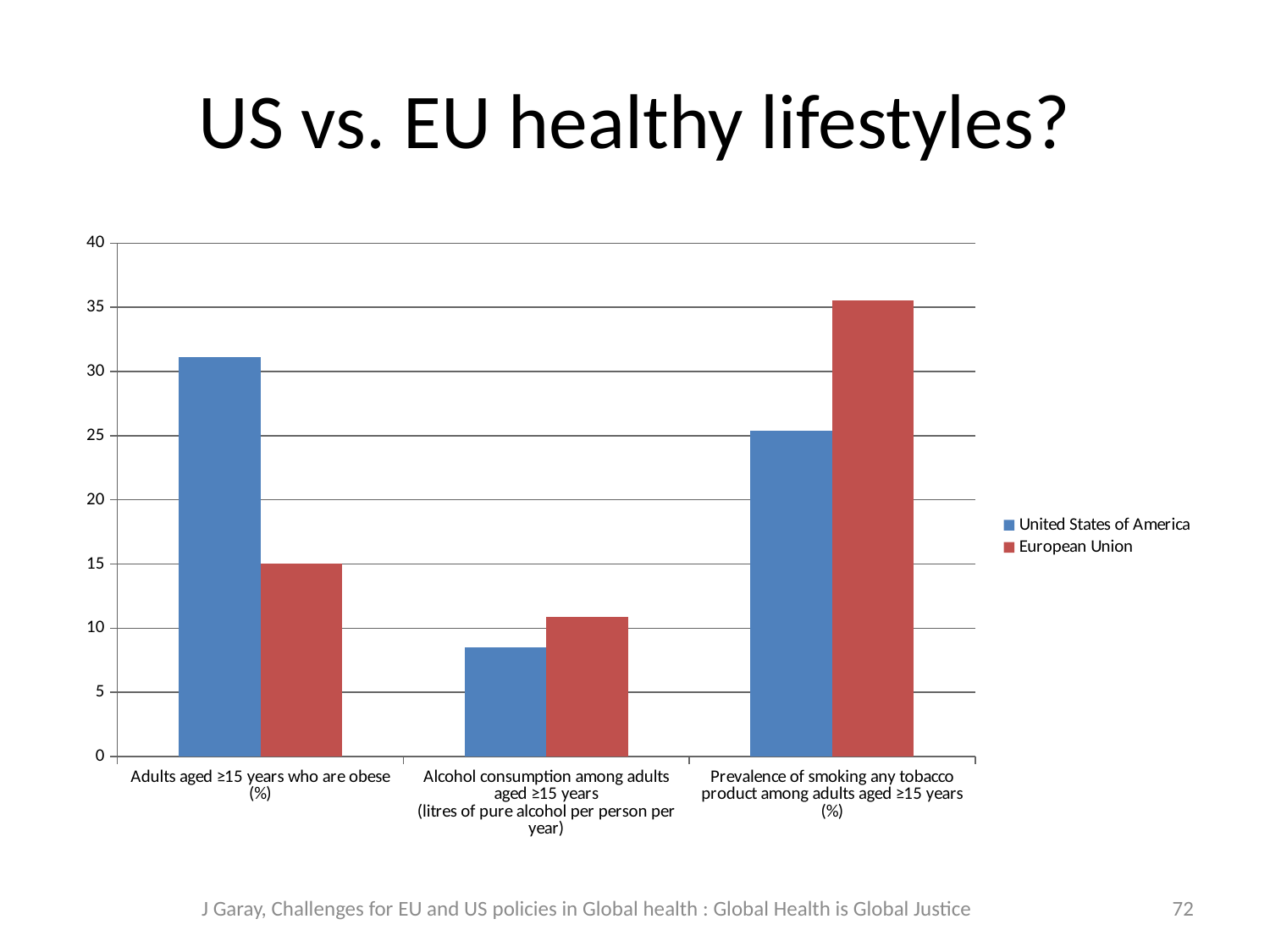
How many categories are shown on the x axis? 3 What is the title of the slide containing the chart? US vs. EU healthy lifestyles? Which category has the lowest value for the United States of America? Alcohol consumption among adults aged ≥15 years (litres of pure alcohol per person per year) Is the value for the United States of America for alcohol consumption among adults aged ≥15 years greater or less than 10? less Is the value for the European Union for prevalence of smoking any tobacco product among adults aged ≥15 years greater or less than 35? greater Is the value for the European Union for alcohol consumption among adults aged ≥15 years greater or less than 10? greater What kind of chart is shown on the slide? bar chart For adults aged ≥15 years who are obese, which is larger: the United States of America or the European Union? United States of America For prevalence of smoking any tobacco product among adults aged ≥15 years, which is larger: the United States of America or the European Union? European Union Which series is shown in blue? United States of America How many series does the legend list? 2